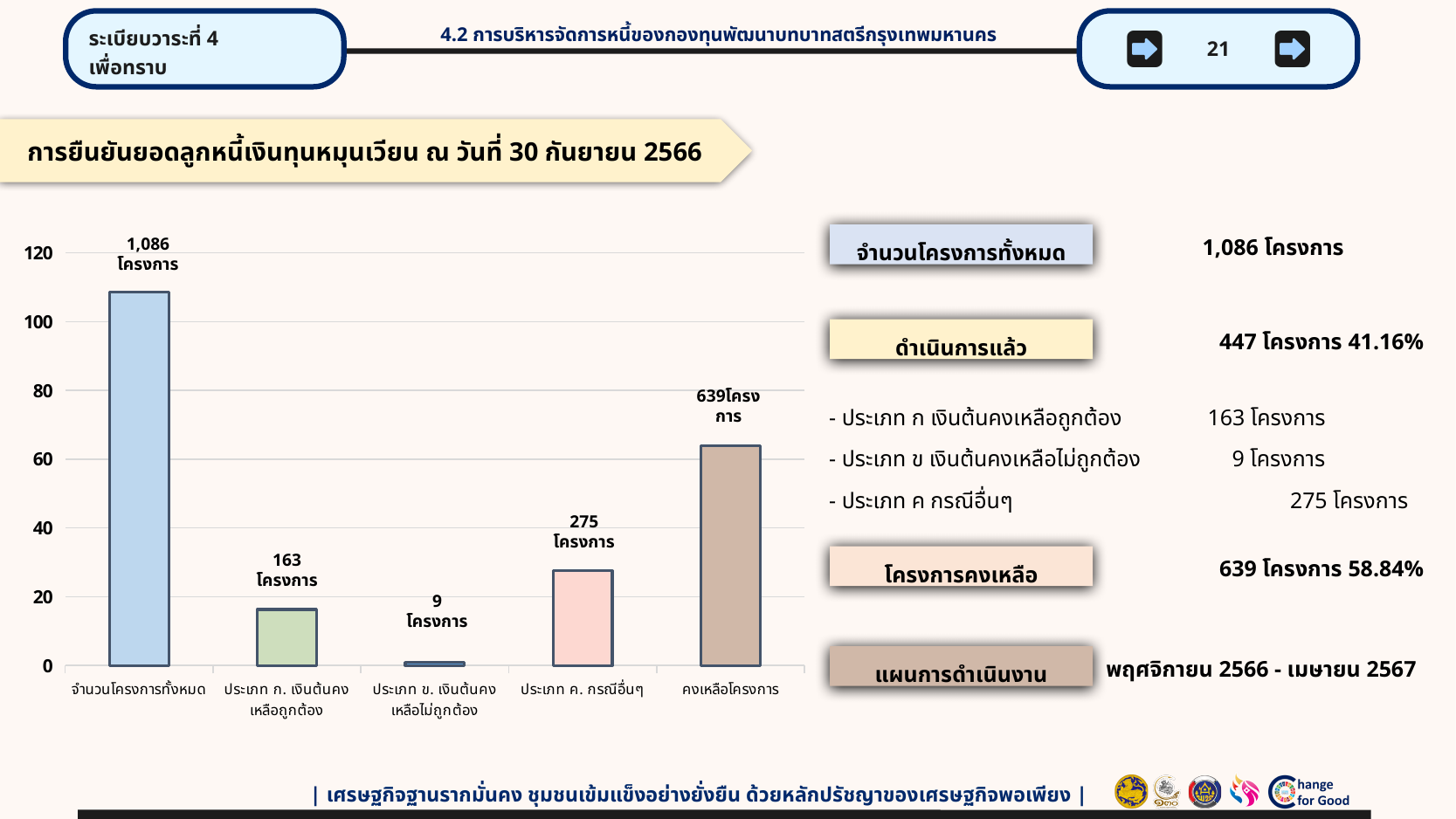
What value is shown for จำนวนโครงการทั้งหมด in the bar chart? 1,086 โครงการ Which category has the lowest value in the bar chart? ประเภท ข. เงินต้นคงเหลือไม่ถูกต้อง What value is shown for ประเภท ข. เงินต้นคงเหลือไม่ถูกต้อง in the bar chart? 9 โครงการ What is the difference between the values for ประเภท ก. เงินต้นคงเหลือถูกต้อง and ประเภท ข. เงินต้นคงเหลือไม่ถูกต้อง? 154 What value is shown for ประเภท ก. เงินต้นคงเหลือถูกต้อง in the bar chart? 163 โครงการ What is the difference between the values for คงเหลือโครงการ and ประเภท ค. กรณีอื่นๆ? 364 What value is shown for คงเหลือโครงการ in the bar chart? 639 โครงการ How many categories are shown in the bar chart? 5 What type of chart is shown on the slide? Bar chart Which is larger, the value for ประเภท ค. กรณีอื่นๆ or the value for ประเภท ก. เงินต้นคงเหลือถูกต้อง? ประเภท ค. กรณีอื่นๆ What value is shown for ประเภท ค. กรณีอื่นๆ in the bar chart? 275 โครงการ Which category has the highest value in the bar chart? จำนวนโครงการทั้งหมด